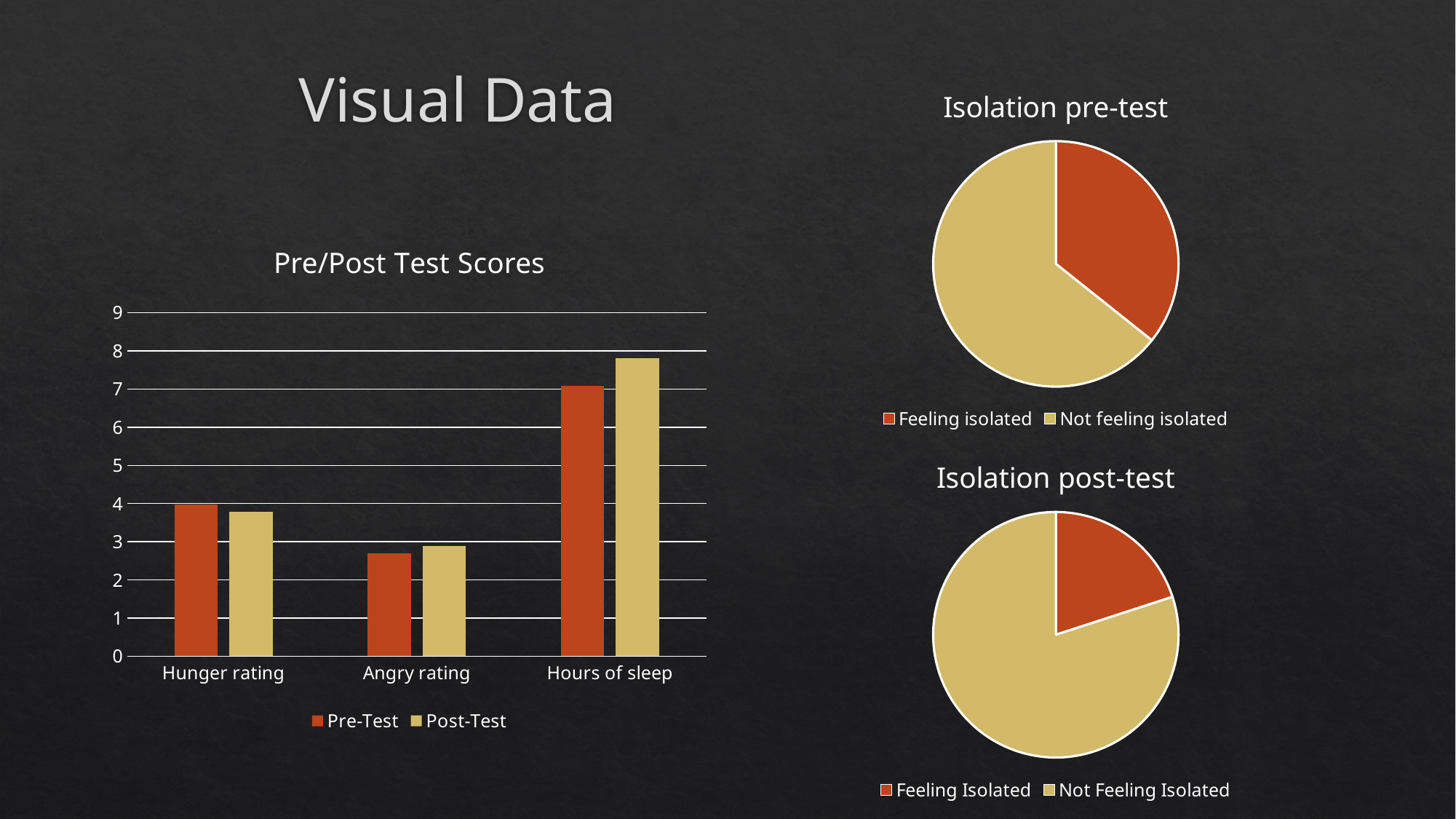
In the "Isolation pre-test" chart, which slice is larger: Feeling isolated or Not feeling isolated? Not feeling isolated What colour represents the Pre-Test series in the "Pre/Post Test Scores" chart? orange-red How many categories are shown on the x axis of the "Pre/Post Test Scores" chart? 3 What kind of chart is the "Pre/Post Test Scores" chart? bar chart In the "Pre/Post Test Scores" chart, for Hours of sleep, which is larger: the Pre-Test or the Post-Test value? Post-Test In the "Isolation post-test" chart, which slice is the smallest? Feeling Isolated How many series does the legend of the "Pre/Post Test Scores" chart list? 2 In the "Pre/Post Test Scores" chart, which category has the highest Pre-Test value? Hours of sleep In the "Pre/Post Test Scores" chart, is the Post-Test value for Hours of sleep greater or less than 7? greater In the "Pre/Post Test Scores" chart, is the Pre-Test value for Angry rating greater or less than 3? less In the "Pre/Post Test Scores" chart, which category has the lowest Post-Test value? Angry rating What kind of chart is the "Isolation pre-test" chart? pie chart